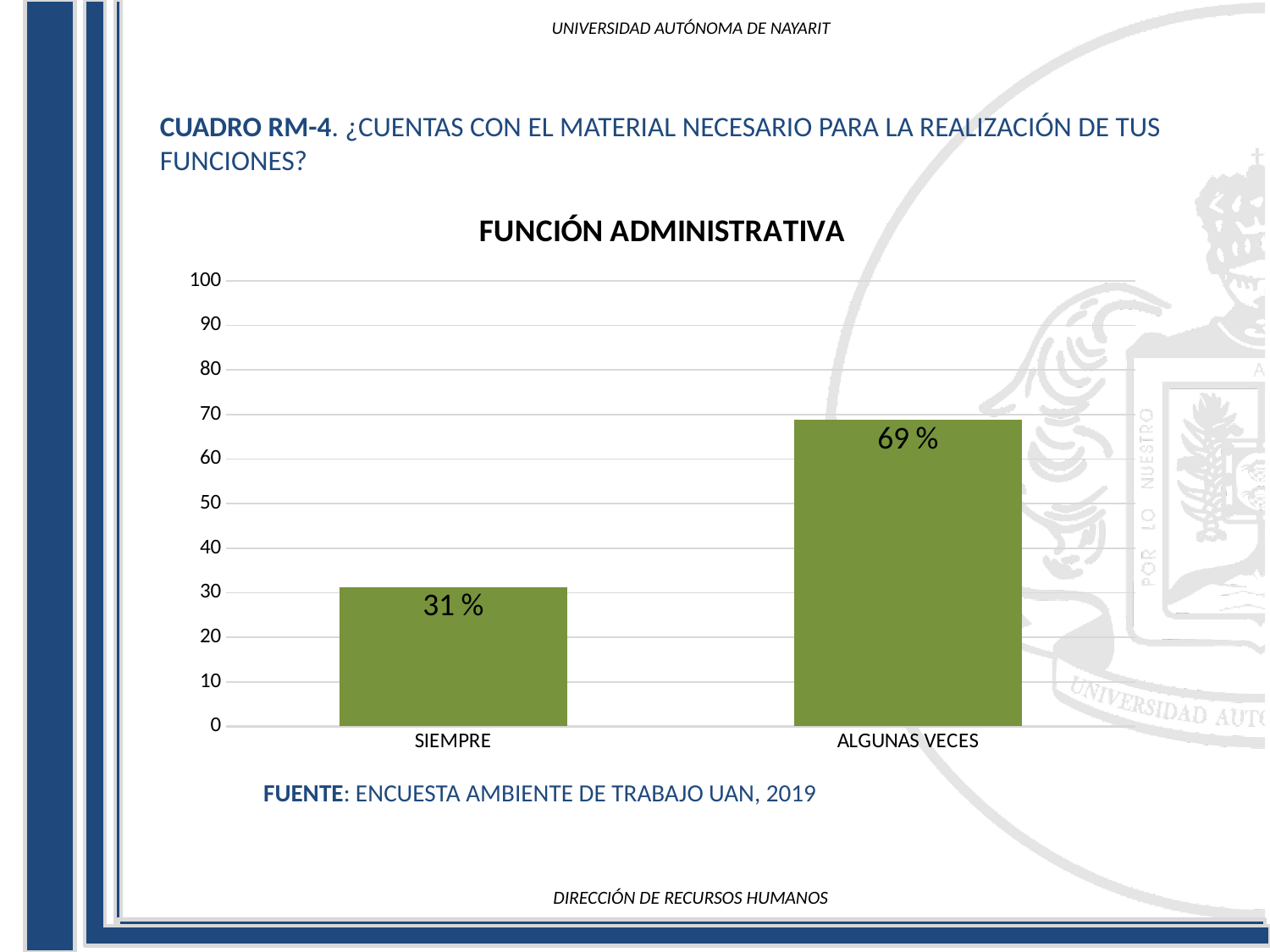
What is the value for ALGUNAS VECES? 69 % What is the highest value shown on the y axis? 100 Which category has the lowest value? SIEMPRE Is the value for ALGUNAS VECES greater or less than 60? greater What kind of chart is shown on the slide? bar chart Which category has the highest value? ALGUNAS VECES Which is larger, the value for SIEMPRE or the value for ALGUNAS VECES? ALGUNAS VECES How many categories are shown on the x axis? 2 What is the title of the chart? FUNCIÓN ADMINISTRATIVA Is the value for SIEMPRE greater or less than 40? less What is the value for SIEMPRE? 31 % What is the difference between the values for ALGUNAS VECES and SIEMPRE? 38 %